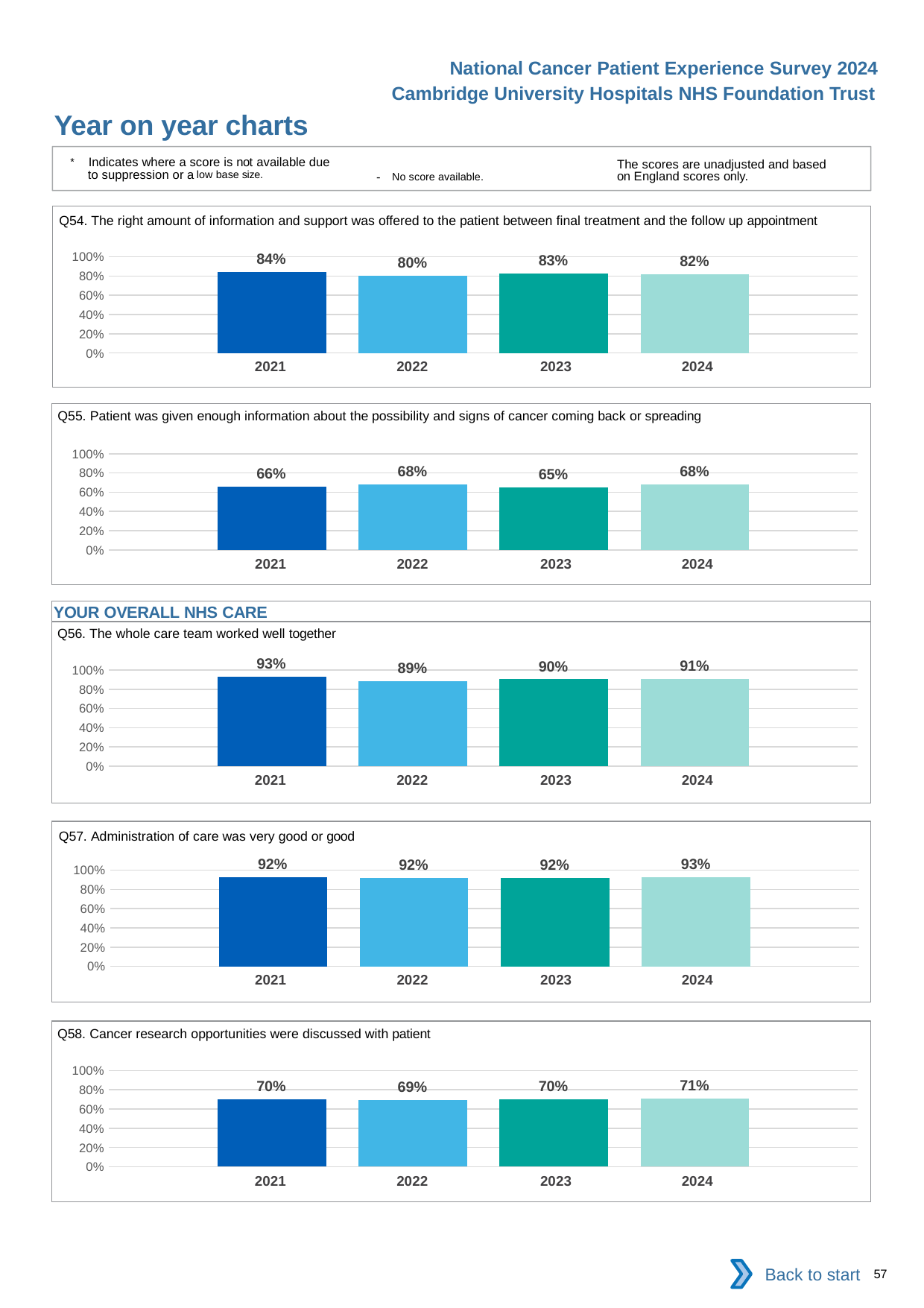
What is the section heading shown above the Q56 chart? YOUR OVERALL NHS CARE In the Q54 chart, which year has the lowest value? 2022 In the Q58 chart, what is the difference between the 2024 value and the 2021 value? 1% In the Q54 chart, what is the value for 2021? 84% In the Q55 chart, what is the value for 2022? 68% In the Q56 chart, which year has the highest value? 2021 In the Q58 chart, what is the value for 2022? 69% In the Q55 chart, what is the difference between the 2024 value and the 2023 value? 3% What kind of chart is the Q58 chart? bar chart In the Q56 chart, is the value for 2022 larger or smaller than the value for 2024? smaller In the Q57 chart, what is the value for 2024? 93% In the Q57 chart, how many years are plotted? 4